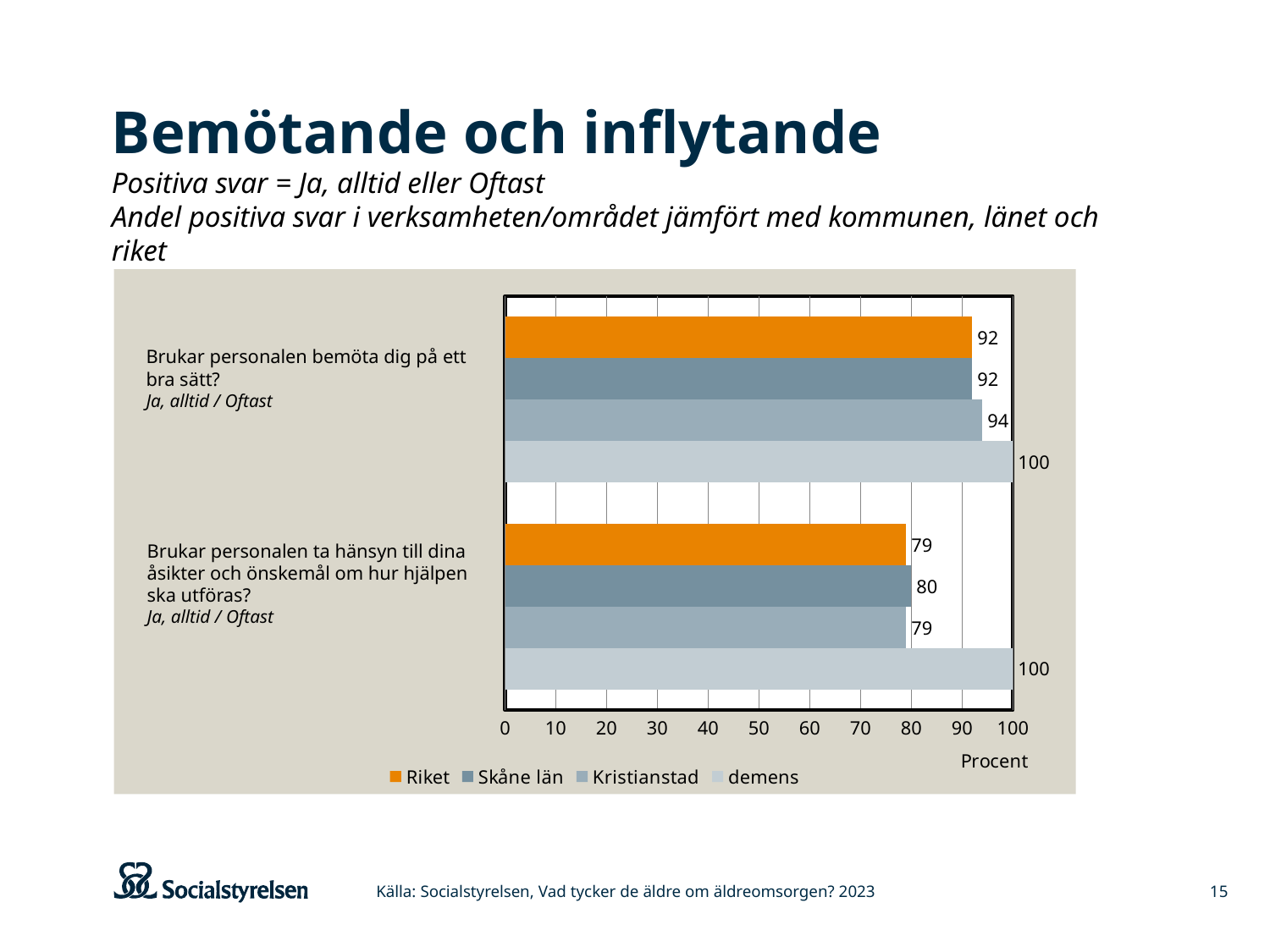
Which is larger for Kristianstad: the value for "Brukar personalen bemöta dig på ett bra sätt?" or the value for "Brukar personalen ta hänsyn till dina åsikter och önskemål om hur hjälpen ska utföras?"? Brukar personalen bemöta dig på ett bra sätt? How many series does the legend list? 4 What is the value for Kristianstad for the question "Brukar personalen bemöta dig på ett bra sätt?"? 94 What is the difference between the demens value and the Riket value for the question "Brukar personalen ta hänsyn till dina åsikter och önskemål om hur hjälpen ska utföras?"? 21 Which series has the highest value for the question "Brukar personalen bemöta dig på ett bra sätt?"? demens What is the value for Riket for the question "Brukar personalen bemöta dig på ett bra sätt?"? 92 What kind of chart is shown on the slide? bar chart What is the value for Skåne län for the question "Brukar personalen ta hänsyn till dina åsikter och önskemål om hur hjälpen ska utföras?"? 80 What is the value for demens for the question "Brukar personalen ta hänsyn till dina åsikter och önskemål om hur hjälpen ska utföras?"? 100 How many survey questions (categories) are shown on the chart? 2 What is the difference between the Kristianstad value and the Riket value for the question "Brukar personalen bemöta dig på ett bra sätt?"? 2 What unit is labelled on the x axis of the chart? Procent